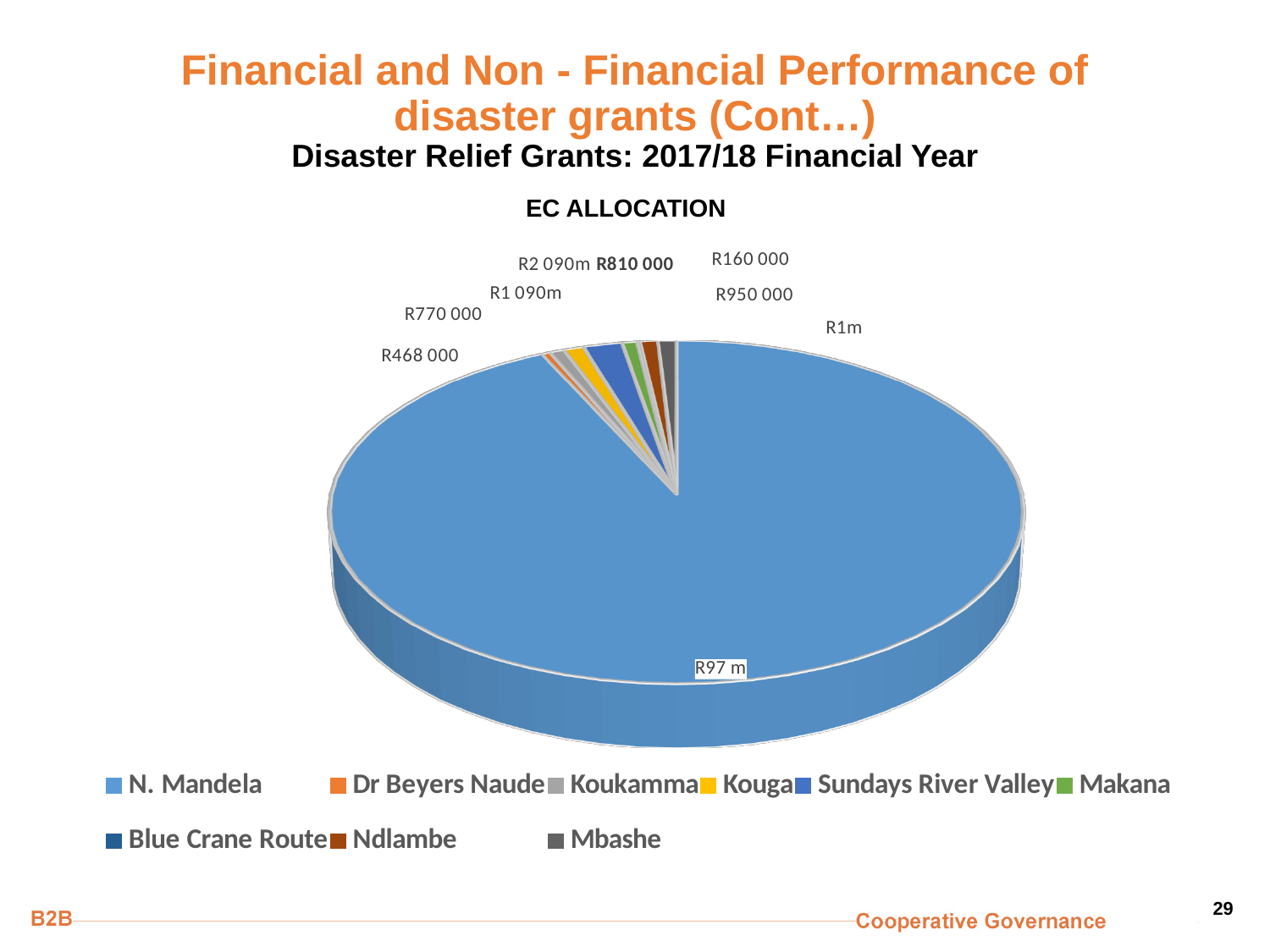
Which is larger in the EC ALLOCATION pie chart, the N. Mandela slice or the Mbashe slice? N. Mandela Which financial year does the Disaster Relief Grants chart on the slide cover? 2017/18 What is the title of the pie chart on the slide? EC ALLOCATION How many municipalities are listed in the legend of the EC ALLOCATION pie chart? 9 What colour is the N. Mandela slice in the EC ALLOCATION pie chart? Light blue What kind of chart is shown under the heading EC ALLOCATION? Pie chart Which municipality has the largest slice in the EC ALLOCATION pie chart? N. Mandela What is the value labelled on the largest slice of the EC ALLOCATION pie chart? R97 m Does the N. Mandela slice make up more or less than half of the EC ALLOCATION pie chart? More